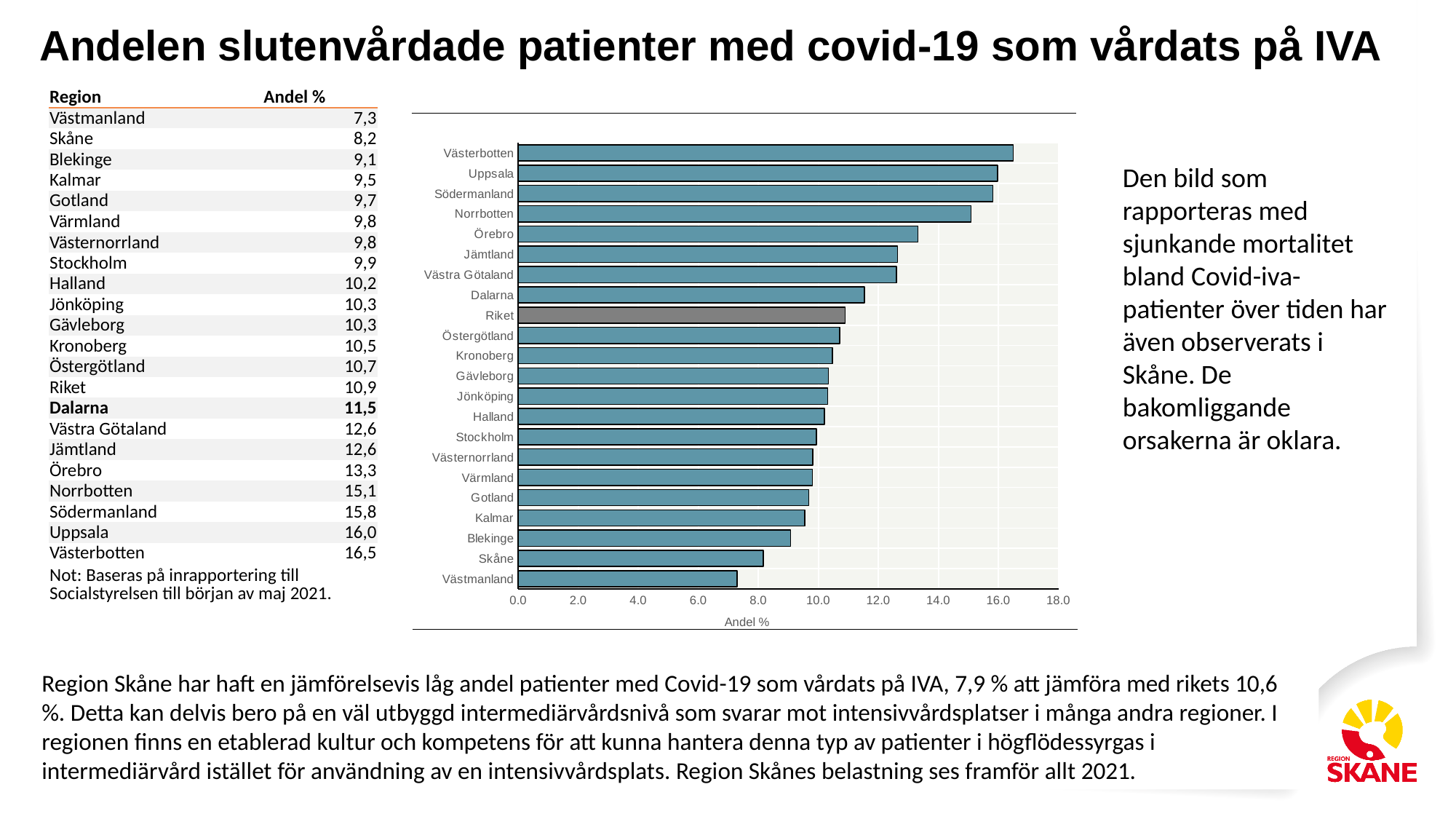
What is the difference between the values for Uppsala and Västmanland? 8,7 What is the value (Andel %) for Västerbotten? 16,5 Which region has the highest share (Andel %) in the bar chart? Västerbotten Which is larger, the value for Örebro or the value for Dalarna? Örebro Is the value for Norrbotten greater or less than 14.0? greater Which region has the lowest share (Andel %) in the bar chart? Västmanland What is the value (Andel %) for Skåne? 8,2 How many bars are plotted in the chart? 22 What kind of chart is shown on the slide? bar chart Is the value for Blekinge greater or less than 10.0? less What is the label of the horizontal axis of the chart? Andel % What is the value (Andel %) for Riket? 10,9